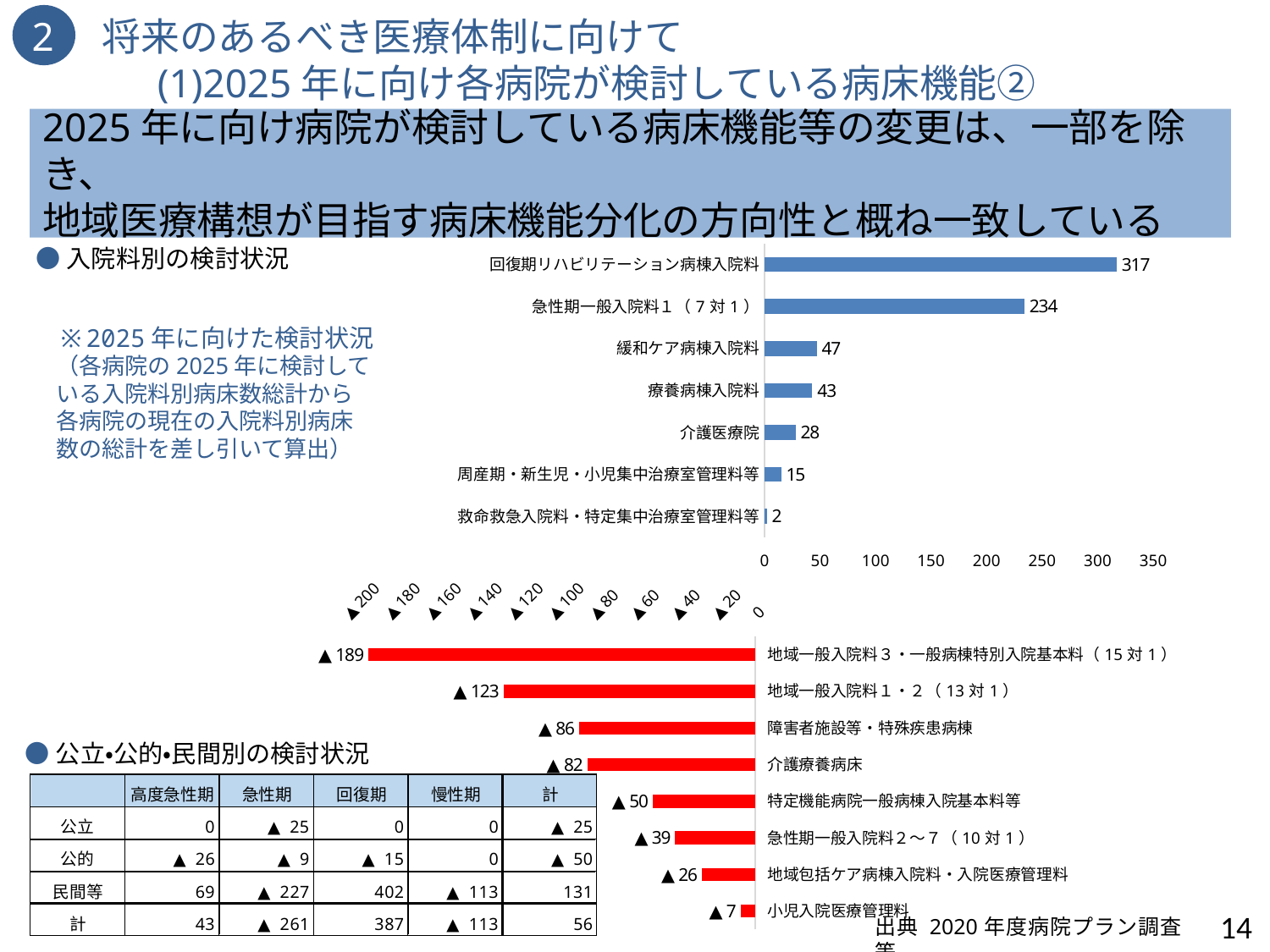
In the upper chart (blue bars), what is the value for 回復期リハビリテーション病棟入院料? 317 In the upper chart (blue bars), what is the difference between 緩和ケア病棟入院料 and 療養病棟入院料? 4 In the lower chart (red bars), what is the value for 介護療養病床? ▲ 82 In the upper chart (blue bars), which category has the lowest value? 救命救急入院料・特定集中治療室管理料等 In the lower chart (red bars), what is the value for 地域一般入院料3・一般病棟特別入院基本料（15対1）? ▲ 189 In the lower chart (red bars), which category has the smallest decrease (shortest bar)? 小児入院医療管理料 What type of chart is the upper chart on the slide? Bar chart In the upper chart (blue bars), how many categories are plotted? 7 In the lower chart (red bars), how many categories are plotted? 8 In the lower chart (red bars), which has the larger decrease: 障害者施設等・特殊疾患病棟 or 急性期一般入院料2～7（10対1）? 障害者施設等・特殊疾患病棟 In the upper chart (blue bars), is the value for 介護医療院 greater or less than 50? less In the upper chart (blue bars), what is the value for 急性期一般入院料1（7対1）? 234